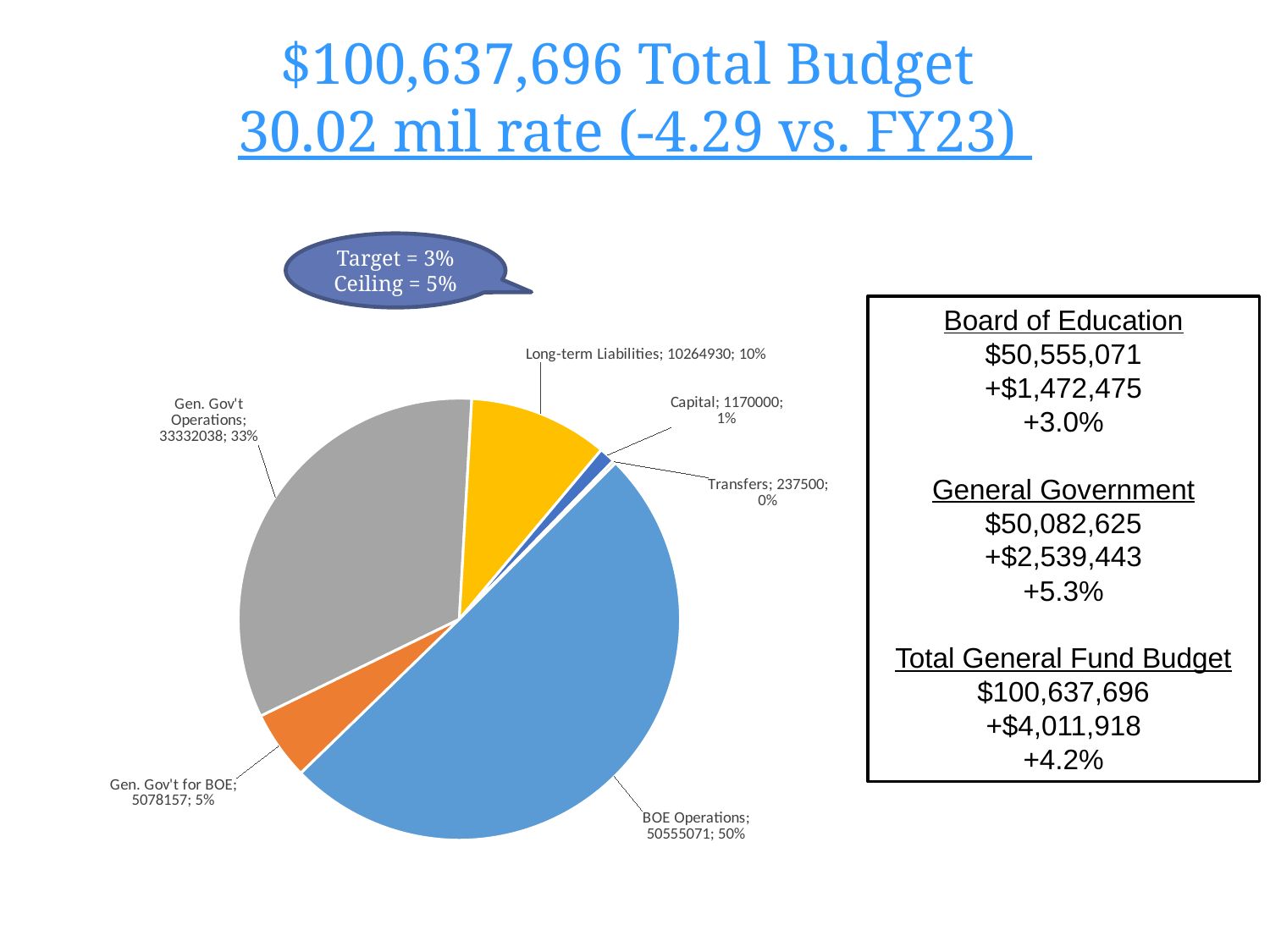
Which slice of the pie chart is the smallest? Transfers What is the value shown for Gen. Gov't Operations in the pie chart? 33332038 How many slices does the pie chart have? 6 What is the value shown for Transfers in the pie chart? 237500 What share of the pie does Gen. Gov't Operations represent? 33% Which is larger in the pie chart, Gen. Gov't for BOE or Capital? Gen. Gov't for BOE What is the value shown for BOE Operations in the pie chart? 50555071 Which slice of the pie chart is the largest? BOE Operations What share of the pie does Gen. Gov't for BOE represent? 5% What is the value shown for Long-term Liabilities in the pie chart? 10264930 What is the difference between the values for Long-term Liabilities and Capital in the pie chart? 9094930 What kind of chart is shown on the slide? Pie chart